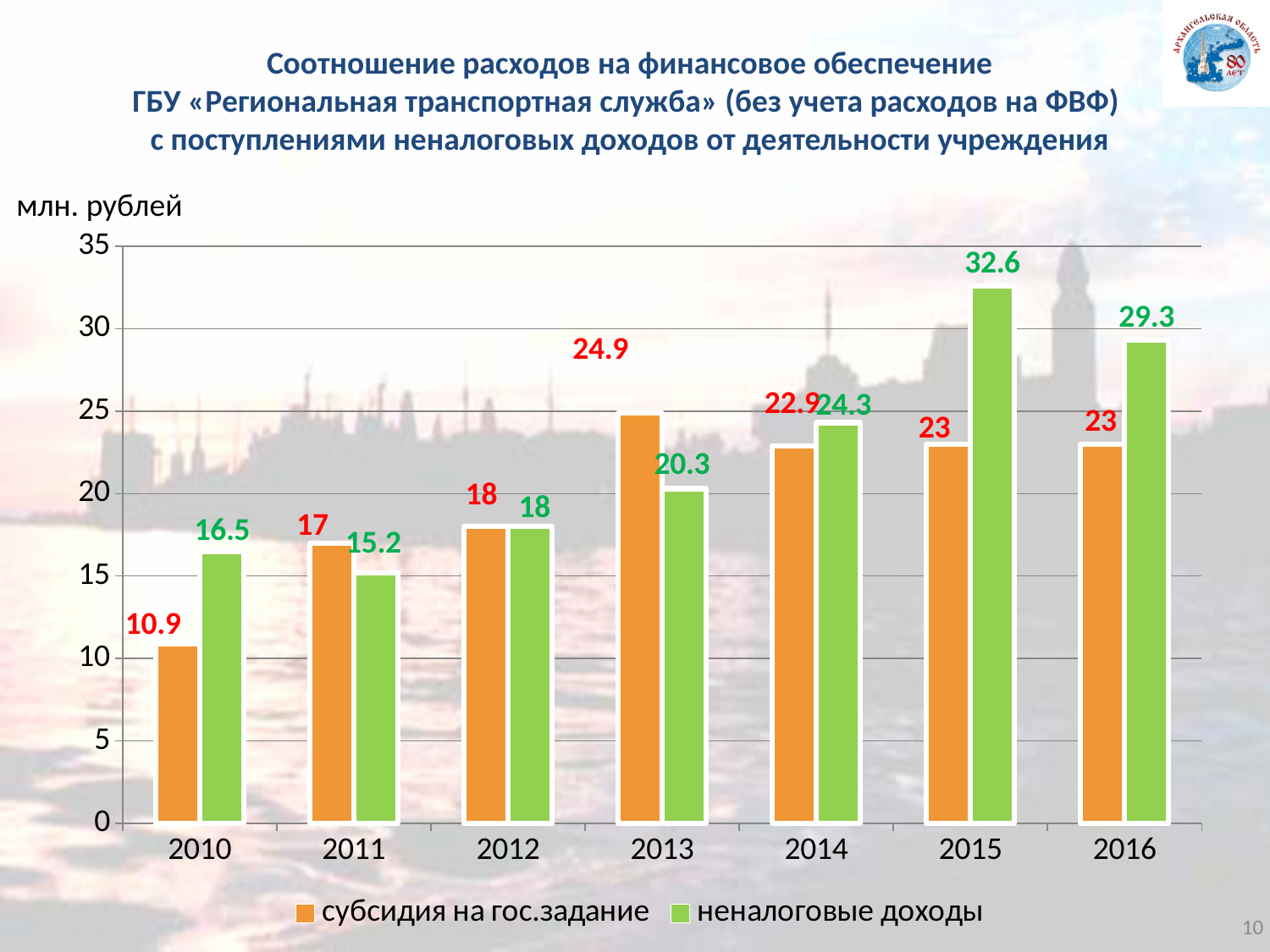
How many years are shown on the x axis? 7 In which year is субсидия на гос.задание lowest? 2010 What unit is indicated above the chart's y axis? млн. рублей What is the value of субсидия на гос.задание for 2010? 10.9 What is the value of неналоговые доходы for 2015? 32.6 What is the difference between неналоговые доходы and субсидия на гос.задание in 2015? 9.6 Which is larger in 2013: субсидия на гос.задание or неналоговые доходы? субсидия на гос.задание How many series does the legend list? 2 What is the value of неналоговые доходы for 2013? 20.3 What kind of chart is shown on the slide? bar chart In which year is неналоговые доходы highest? 2015 Does неналоговые доходы rise or fall from 2013 to 2015? rise